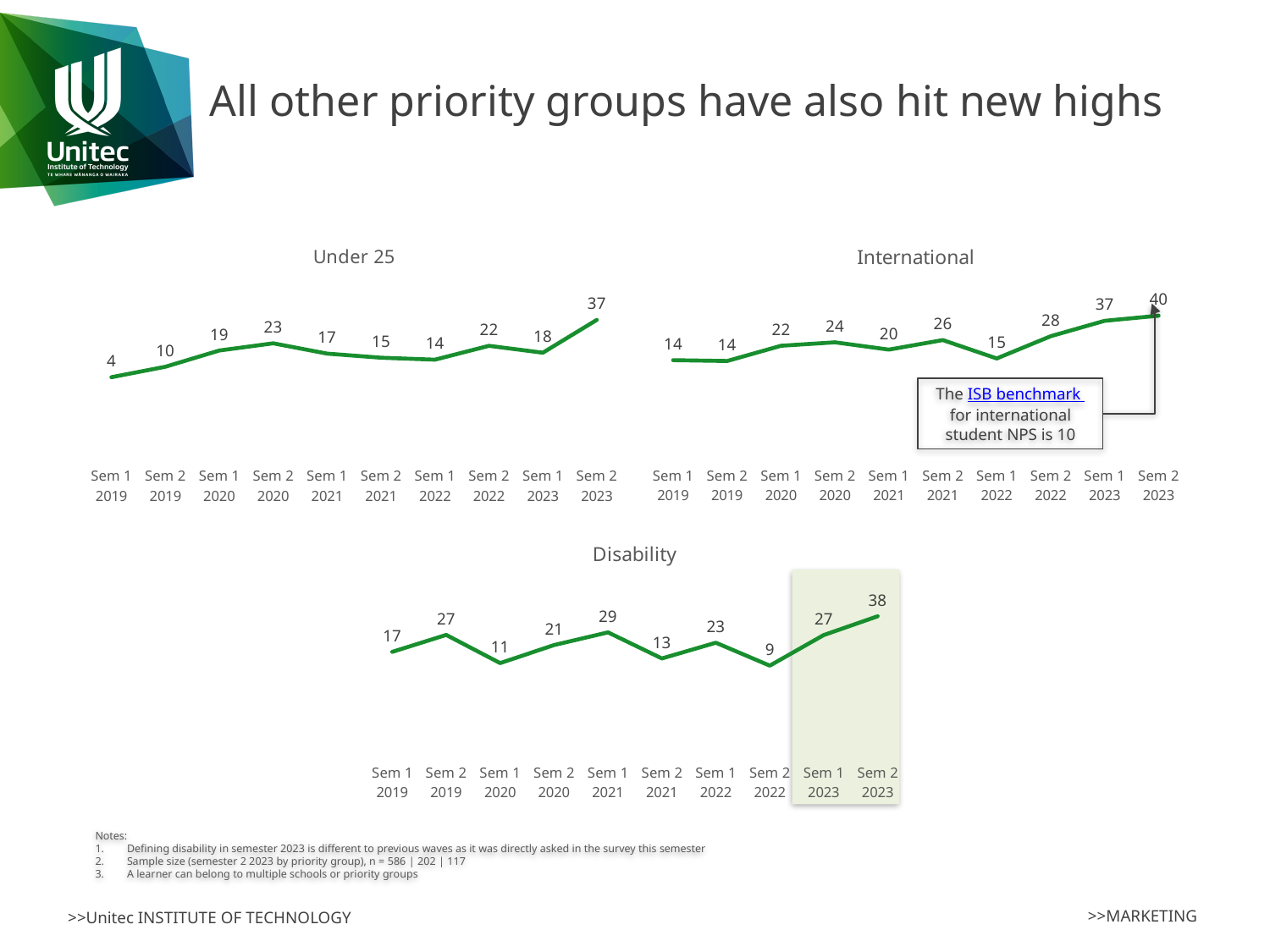
How many data points are plotted in the Disability chart? 10 In the Under 25 chart, which semester has the highest value? Sem 2 2023 In the International chart, which semester has the lowest value? Sem 1 2019 and Sem 2 2019 What type of chart is the Under 25 chart? Line chart In the International chart, what is the value for Sem 2 2023? 40 In the International chart, which is larger: the value for Sem 2 2021 or the value for Sem 1 2022? Sem 2 2021 According to the callout on the International chart, what is the ISB benchmark for international student NPS? 10 In the Disability chart, what is the value for Sem 2 2022? 9 In the Disability chart, which semester has the highest value? Sem 2 2023 In the Disability chart, what is the difference between the Sem 2 2023 value and the Sem 1 2023 value? 11 In the Under 25 chart, what is the difference between the Sem 2 2023 value and the Sem 1 2023 value? 19 In the Under 25 chart, what is the value for Sem 1 2019? 4